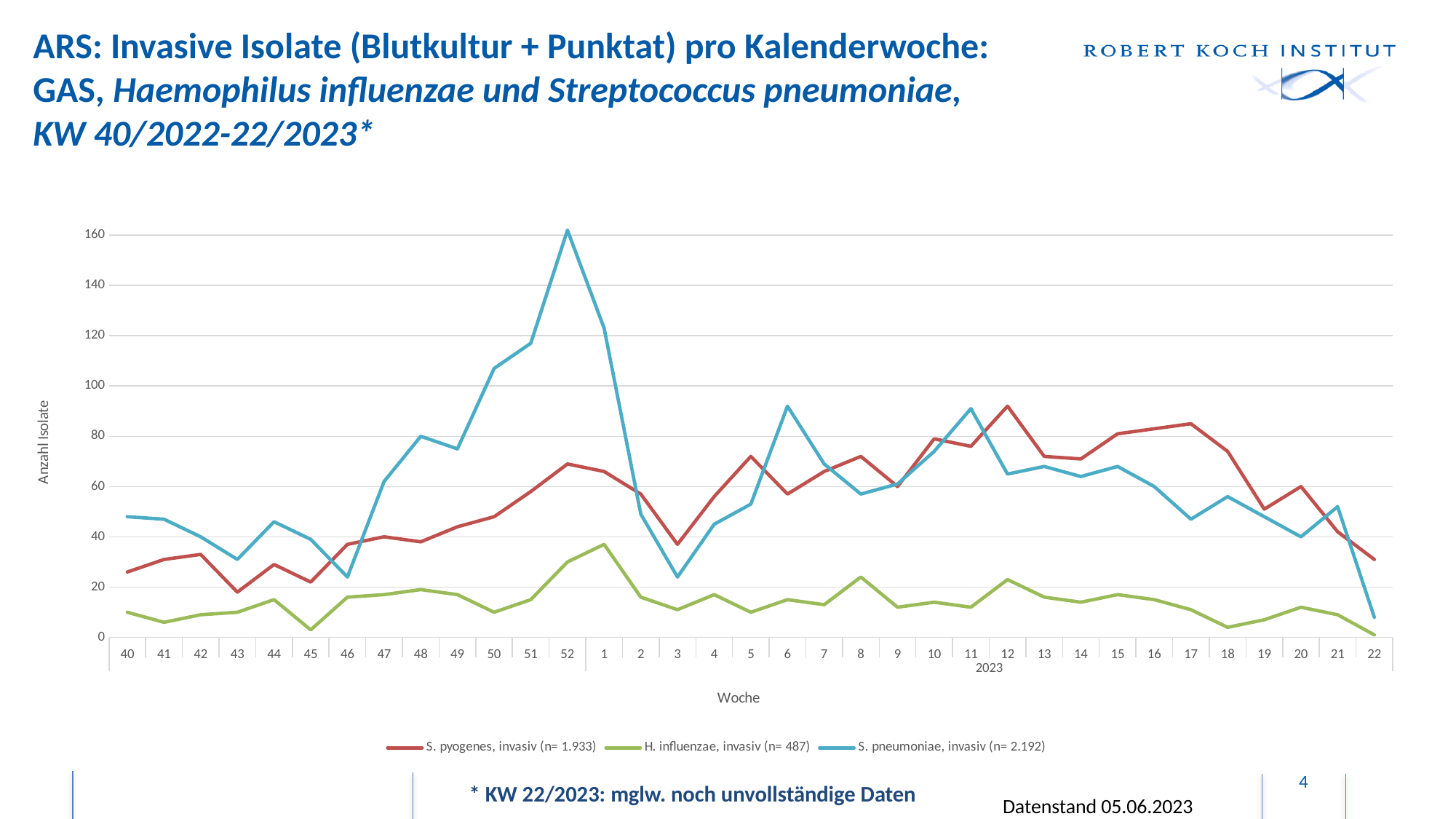
Does the S. pneumoniae, invasiv series rise or fall from week 52 to week 3? fall In which calendar week does the S. pneumoniae, invasiv series reach its highest value? 52 Which series has the higher value in week 52: S. pyogenes, invasiv or S. pneumoniae, invasiv? S. pneumoniae, invasiv How many calendar weeks are plotted along the x axis? 35 Is the value for S. pneumoniae, invasiv in week 22 greater or less than 20? less Is the value for H. influenzae, invasiv in week 1 greater or less than 40? less Is the value for S. pyogenes, invasiv in week 12 greater or less than 80? greater Which series has the lowest values across the whole period? H. influenzae, invasiv What total number of isolates (n) does the legend give for S. pneumoniae, invasiv? 2.192 How many series does the legend list? 3 What kind of chart is shown on the slide? line chart